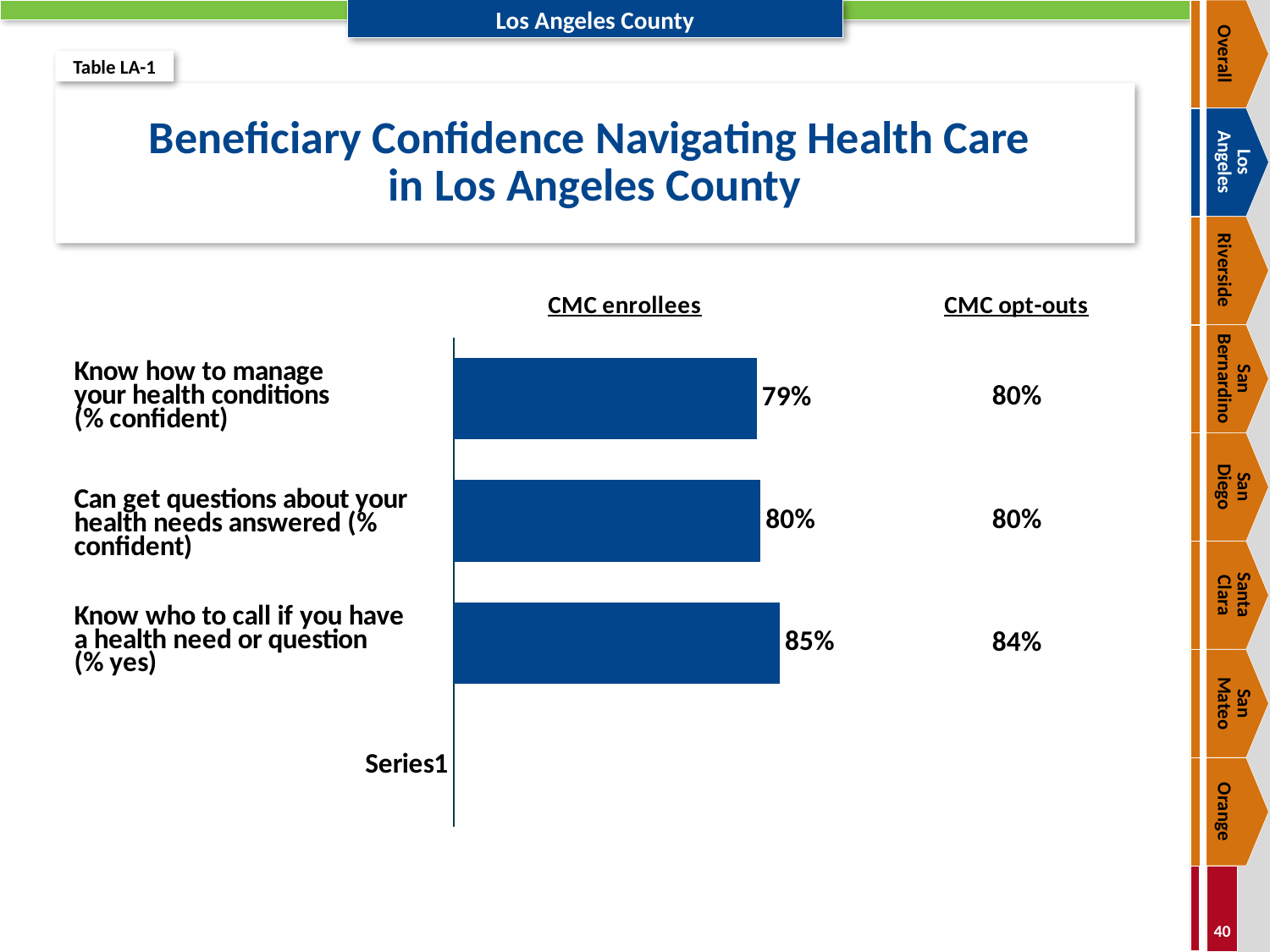
What type of chart is shown on the slide? Bar chart What is the CMC enrollees value for 'Can get questions about your health needs answered'? 80% Which item has the highest value among CMC enrollees? Know who to call if you have a health need or question Which item has the lowest value among CMC enrollees? Know how to manage your health conditions How many bars are plotted in the chart? 3 What percentage of CMC enrollees say they know how to manage their health conditions? 79% What is the difference between the highest and lowest CMC enrollees values? 6 percentage points What is the CMC opt-outs value for 'Know who to call if you have a health need or question'? 84% For 'Know how to manage your health conditions', what is the difference between the CMC opt-outs and CMC enrollees values? 1 percentage point What percentage of CMC enrollees know who to call if they have a health need or question? 85% What is the title of the chart on the slide? Beneficiary Confidence Navigating Health Care in Los Angeles County For 'Know who to call if you have a health need or question', which group has the higher value, CMC enrollees or CMC opt-outs? CMC enrollees